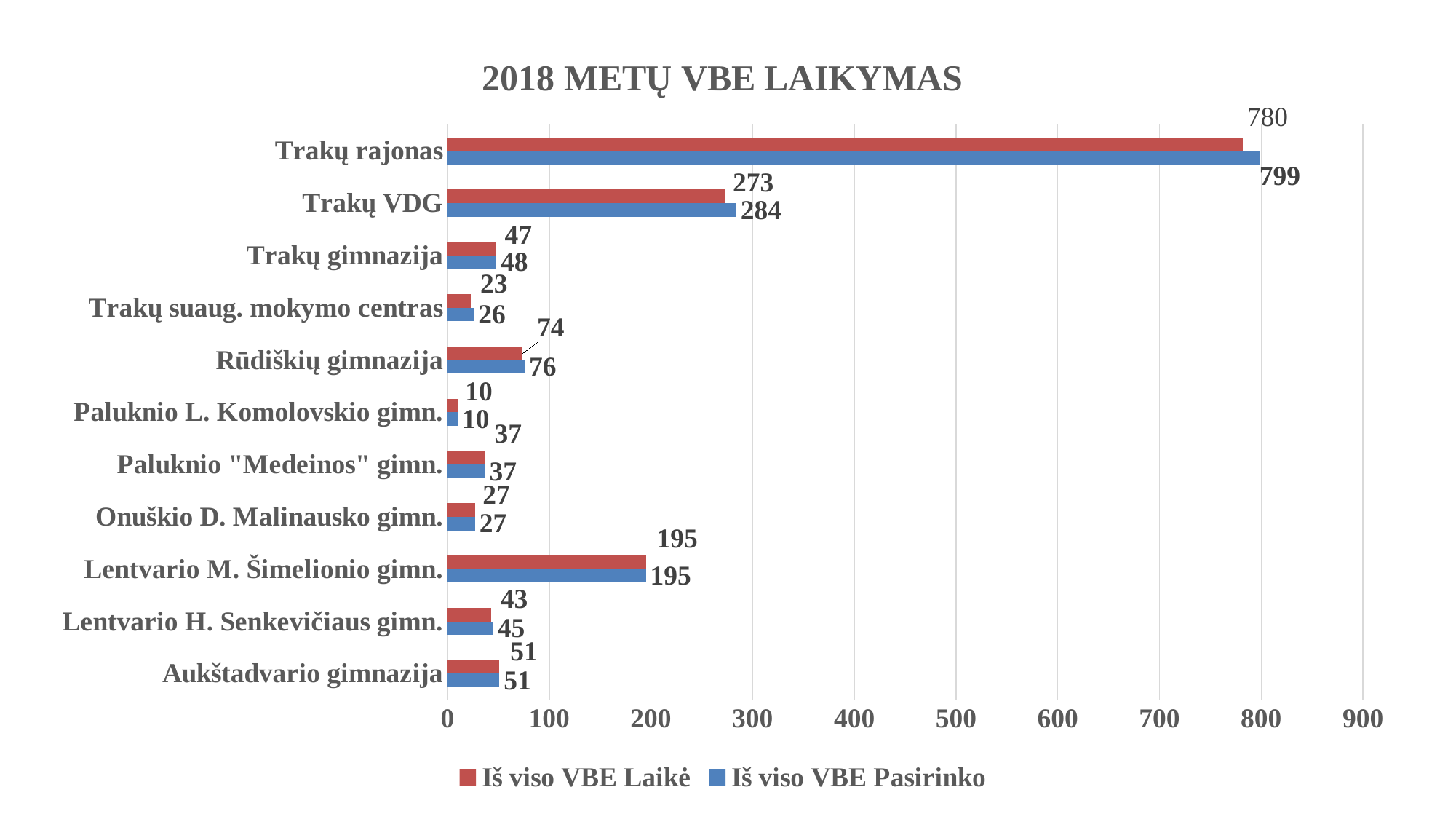
Which category has the highest value for "Iš viso VBE Pasirinko"? Trakų rajonas What is the title of the chart? 2018 METŲ VBE LAIKYMAS Which is larger for Lentvario H. Senkevičiaus gimn.: "Iš viso VBE Laikė" or "Iš viso VBE Pasirinko"? Iš viso VBE Pasirinko What is the value of "Iš viso VBE Laikė" for Trakų VDG? 273 What is the value of "Iš viso VBE Pasirinko" for Trakų rajonas? 799 Which category has the lowest value for "Iš viso VBE Laikė"? Paluknio L. Komolovskio gimn. What type of chart is shown on the slide? bar chart How many series does the legend list? 2 Is the value of "Iš viso VBE Laikė" for Lentvario M. Šimelionio gimn. greater or less than 100? greater What is the difference between "Iš viso VBE Pasirinko" and "Iš viso VBE Laikė" for Trakų rajonas? 19 What is the value of "Iš viso VBE Pasirinko" for Rūdiškių gimnazija? 76 How many categories are shown on the chart? 11